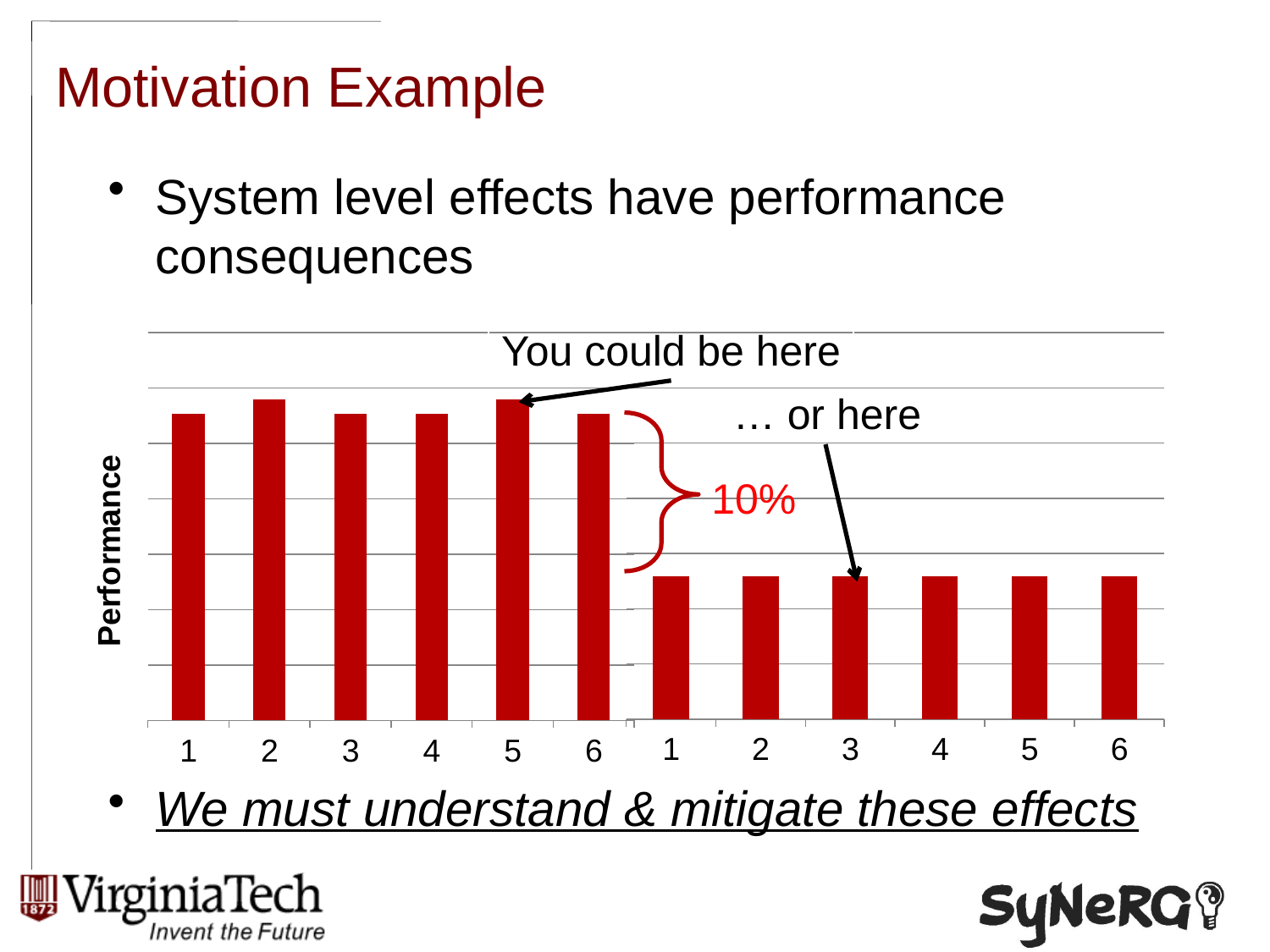
What is the label on the vertical axis of the chart? Performance What percentage is written next to the brace marking the gap between the left group of bars and the right group of bars? 10% Which is larger: the bar labelled 6 in the left group or the bar labelled 3 in the right group? the bar labelled 6 in the left group How many bars are plotted in the chart? 12 What kind of chart is shown on the slide? bar chart Moving from the left group of bars to the right group of bars, do the performance values rise or fall? fall Which is larger: the bar labelled 1 in the left group or the bar labelled 1 in the right group? the bar labelled 1 in the left group Which group of bars has the lower performance values, the left group or the right group? the right group How many bars are in the left group of the chart (labelled 1 to 6)? 6